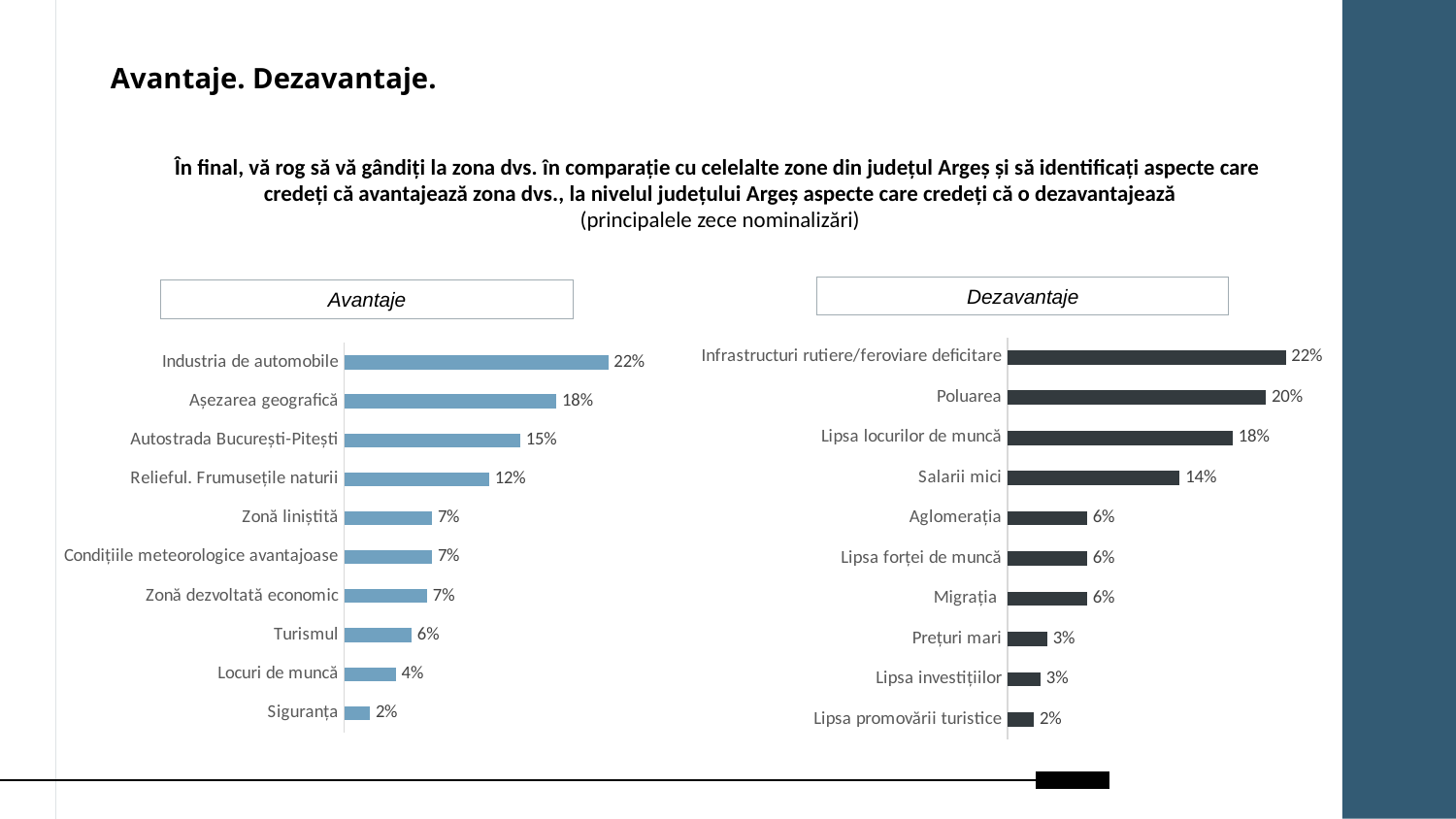
In the Dezavantaje chart, which category has the highest value? Infrastructuri rutiere/feroviare deficitare In the Avantaje chart, which is larger: Turismul or Relieful. Frumusețile naturii? Relieful. Frumusețile naturii In the Avantaje chart, what is the difference between Așezarea geografică and Autostrada București-Pitești? 3% In the Dezavantaje chart, which is larger: Aglomerația or Prețuri mari? Aglomerația In the Dezavantaje chart, what is the value for Salarii mici? 14% In the Avantaje chart, which category has the lowest value? Siguranța How many categories are shown in the Avantaje chart? 10 How many categories are shown in the Dezavantaje chart? 10 In the Dezavantaje chart, what is the difference between Poluarea and Lipsa locurilor de muncă? 2% What kind of chart is the Dezavantaje chart? Bar chart In the Avantaje chart, what is the value for Industria de automobile? 22% In the Avantaje chart, what is the value for Locuri de muncă? 4%